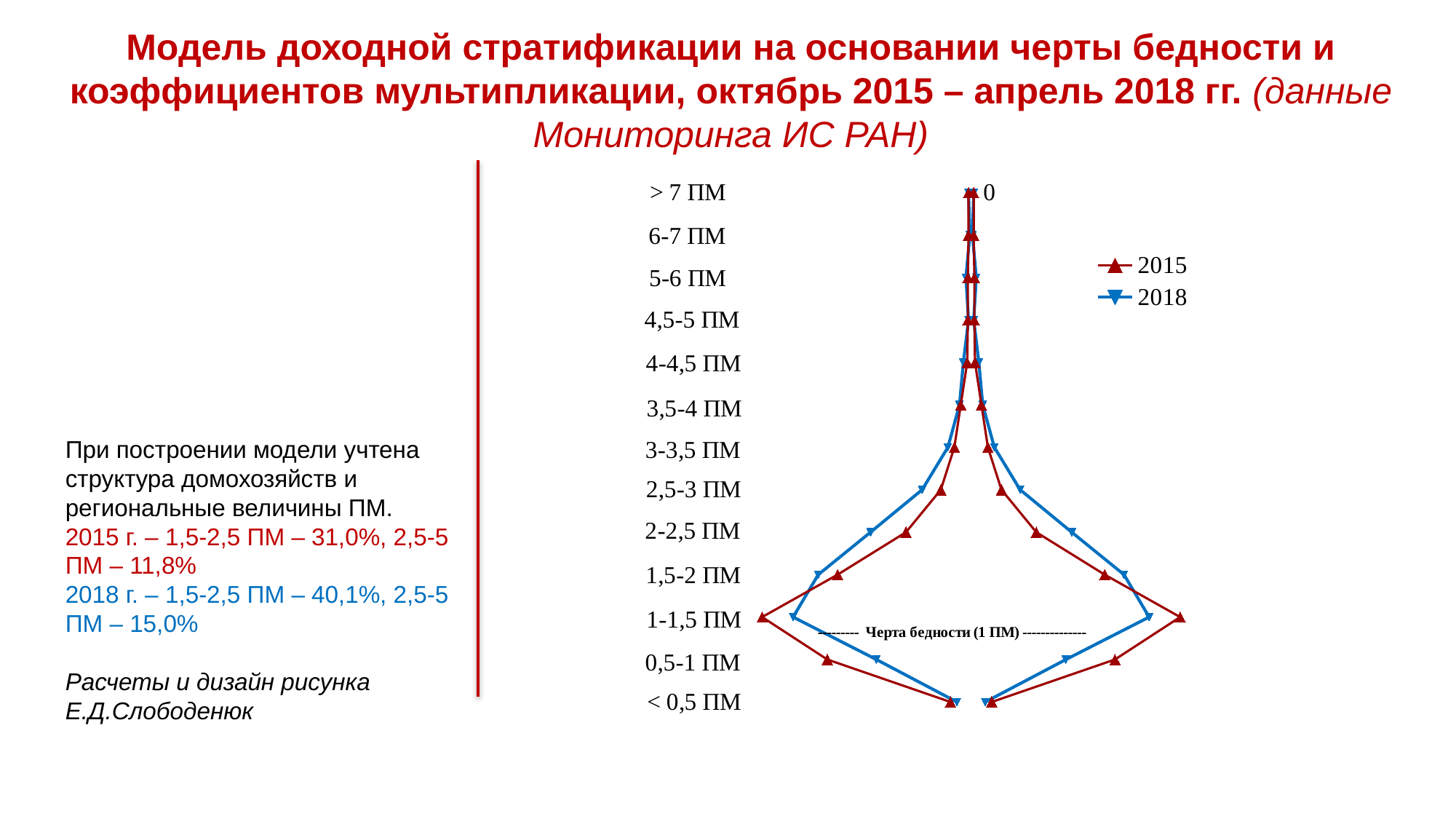
Which income category has the smallest share, marked with the value 0 on the chart? > 7 ПМ How many income categories (ПМ groups) are shown on the chart? 13 Which two series are listed in the chart legend? 2015 and 2018 Which income category has the widest spread (largest share) for the 2018 series? 1-1,5 ПМ What kind of chart is shown on the slide? line chart In the 1-1,5 ПМ category, which series has the larger share, 2015 or 2018? 2015 What label is written on the dashed line drawn across the chart at the 1-1,5 ПМ level? Черта бедности (1 ПМ) How many series does the chart legend list? 2 In the 2-2,5 ПМ category, which series has the larger share, 2015 or 2018? 2018 In the 0,5-1 ПМ category, which series has the larger share, 2015 or 2018? 2015 Which income category has the widest spread (largest share) for the 2015 series? 1-1,5 ПМ